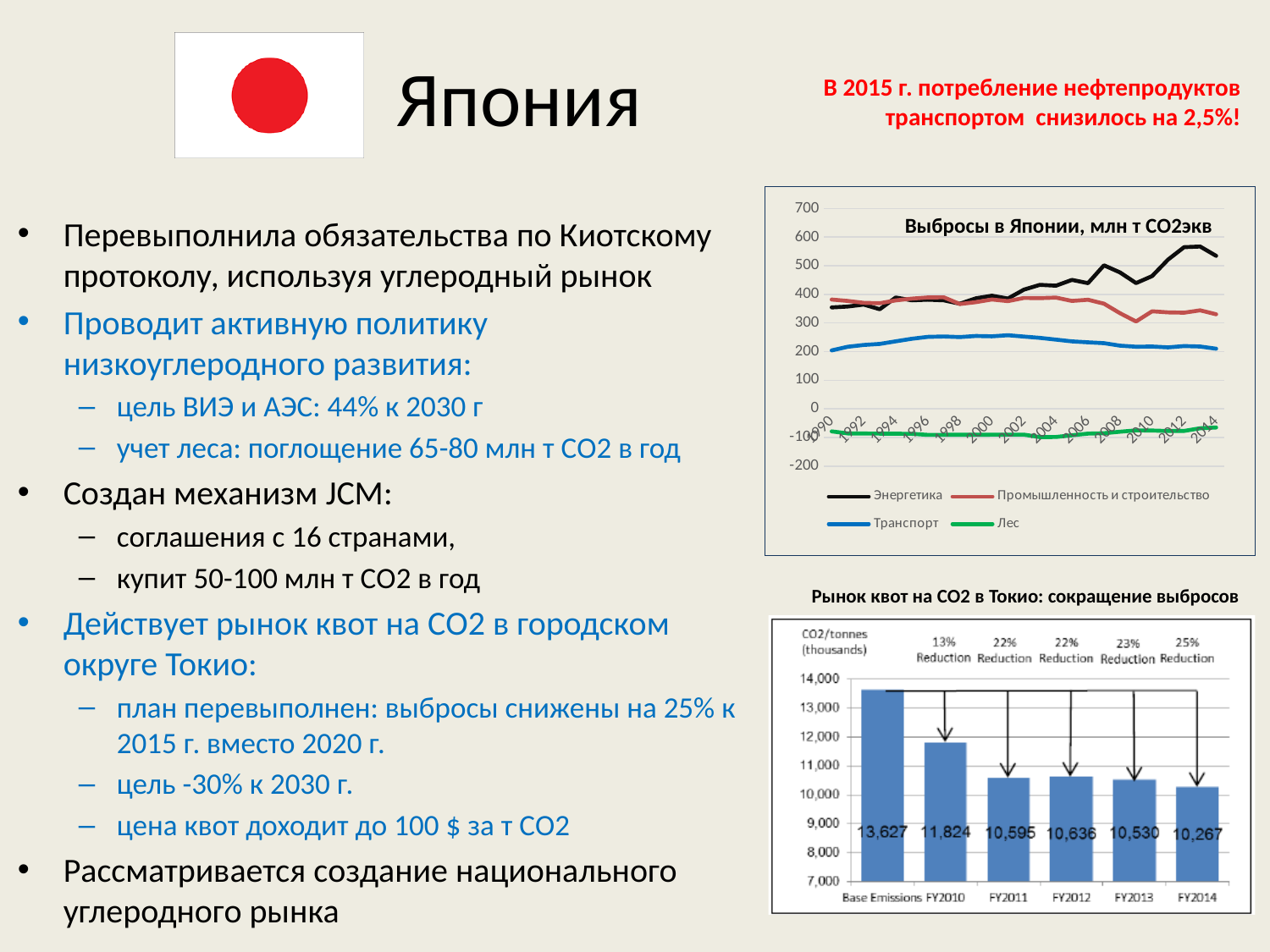
In the chart 'Рынок квот на CO2 в Токио: сокращение выбросов', what is the value for FY2012? 10,636 In the chart 'Рынок квот на CO2 в Токио: сокращение выбросов', what is the value for Base Emissions? 13,627 What kind of chart is 'Выбросы в Японии, млн т CO2экв'? line chart In the chart 'Рынок квот на CO2 в Токио: сокращение выбросов', which category has the highest value? Base Emissions In the chart 'Рынок квот на CO2 в Токио: сокращение выбросов', what percentage reduction is shown above FY2014? 25% In the chart 'Рынок квот на CO2 в Токио: сокращение выбросов', which category has the lowest value? FY2014 How many series does the legend of the chart 'Выбросы в Японии, млн т CO2экв' list? 4 In the chart 'Выбросы в Японии, млн т CO2экв', which series is shown in green? Лес In the chart 'Рынок квот на CO2 в Токио: сокращение выбросов', what is the difference between Base Emissions and FY2010? 1,803 In the chart 'Рынок квот на CO2 в Токио: сокращение выбросов', how many bars are shown? 6 In the chart 'Рынок квот на CO2 в Токио: сокращение выбросов', what is the value for FY2014? 10,267 In the chart 'Выбросы в Японии, млн т CO2экв', is the value for Энергетика in 2012 greater or less than 500? greater